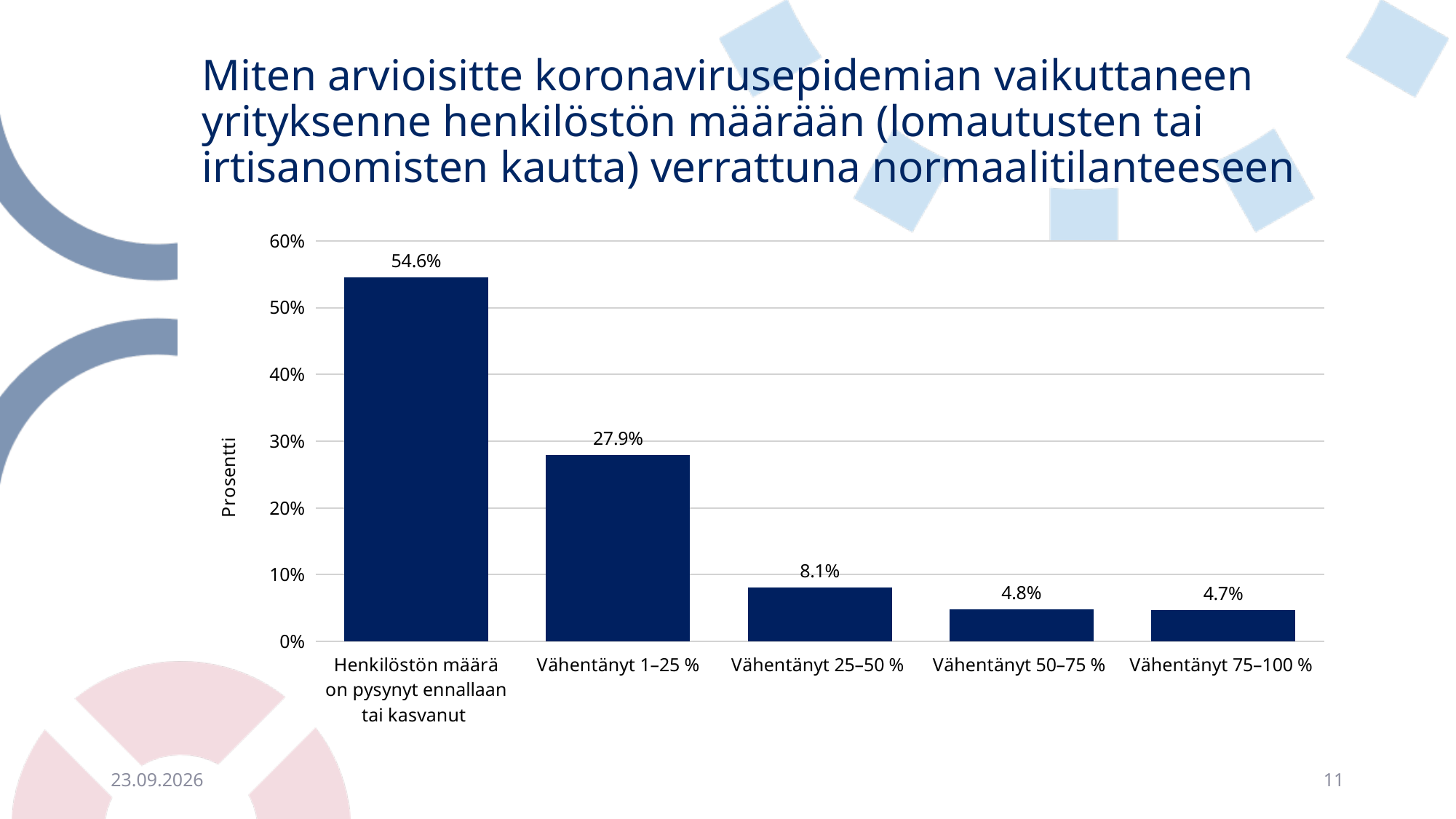
How many categories are shown on the x axis? 5 What is the value for "Vähentänyt 75–100 %"? 4.7% What is the value for "Vähentänyt 1–25 %"? 27.9% Which is larger, the value for "Vähentänyt 1–25 %" or the value for "Vähentänyt 25–50 %"? Vähentänyt 1–25 % What is the difference between the values for "Vähentänyt 25–50 %" and "Vähentänyt 50–75 %"? 3.3% What kind of chart is shown on the slide? bar chart What is the difference between the values for "Henkilöstön määrä on pysynyt ennallaan tai kasvanut" and "Vähentänyt 1–25 %"? 26.7% Is the value for "Vähentänyt 1–25 %" greater or less than 30%? less What is the value for "Vähentänyt 25–50 %"? 8.1% Which category has the highest value? Henkilöstön määrä on pysynyt ennallaan tai kasvanut What is the label of the vertical axis? Prosentti What is the value for "Henkilöstön määrä on pysynyt ennallaan tai kasvanut"? 54.6%